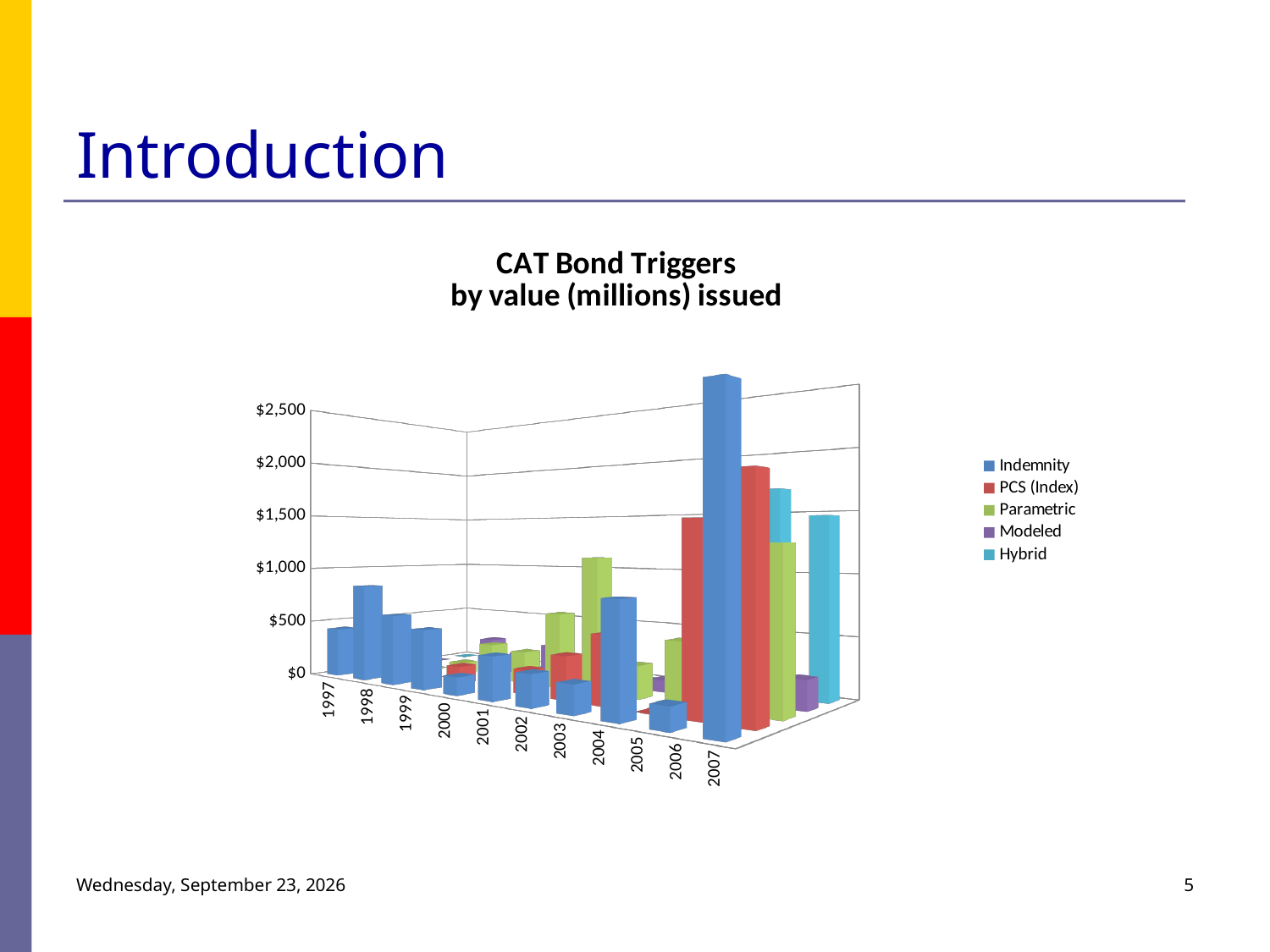
In 2007, which is larger: the Hybrid value or the Modeled value? Hybrid In 2007, which is larger: the Indemnity value or the PCS (Index) value? Indemnity Is the Indemnity value for 2007 greater or less than $2,000? greater What is the title of the chart? CAT Bond Triggers by value (millions) issued Which series is shown in green in the legend? Parametric What kind of chart is shown on the slide? bar chart Does the Indemnity value rise or fall from 1998 to 2000? fall How many series does the legend list? 5 In which year is the Indemnity value highest? 2007 Which is larger: the Parametric value for 2004 or for 2005? 2005 How many years are shown along the x axis? 11 Is the Indemnity value for 1998 greater or less than $500? greater